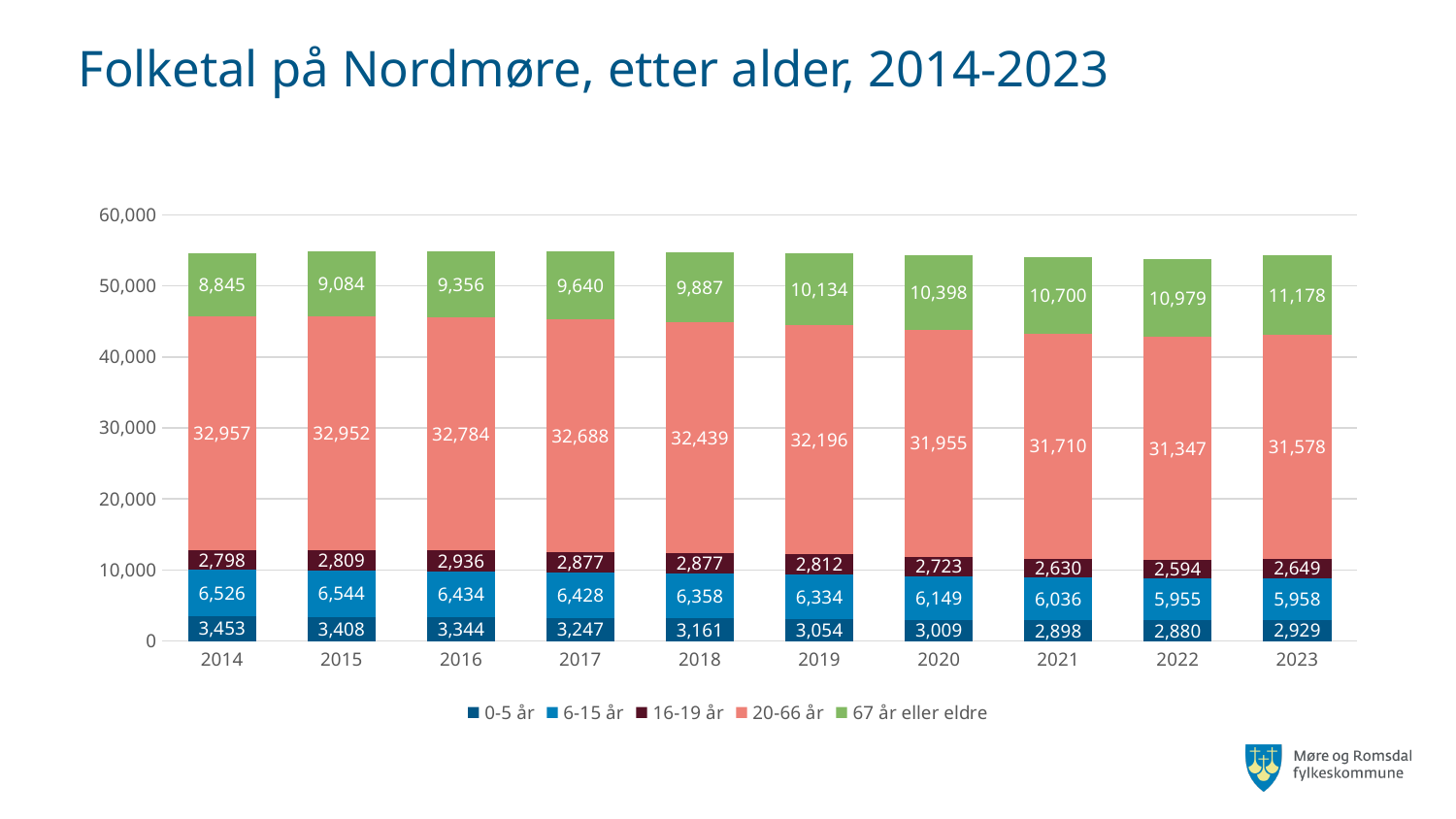
What is the value for the 0-5 år series in 2019? 3,054 How many years are shown on the x axis? 10 Does the 67 år eller eldre series rise or fall from 2014 to 2023? rise Is the total height of the 2014 bar greater or less than 50,000? greater In which year is the 67 år eller eldre series highest? 2023 Which is larger, the 6-15 år value in 2014 or in 2023? 2014 What is the difference between the 67 år eller eldre value in 2023 and in 2014? 2,333 What is the value for the 67 år eller eldre series in 2023? 11,178 How many series does the legend list? 5 What kind of chart is shown on the slide? stacked bar chart In which year is the 0-5 år series lowest? 2022 What is the value for the 20-66 år series in 2014? 32,957